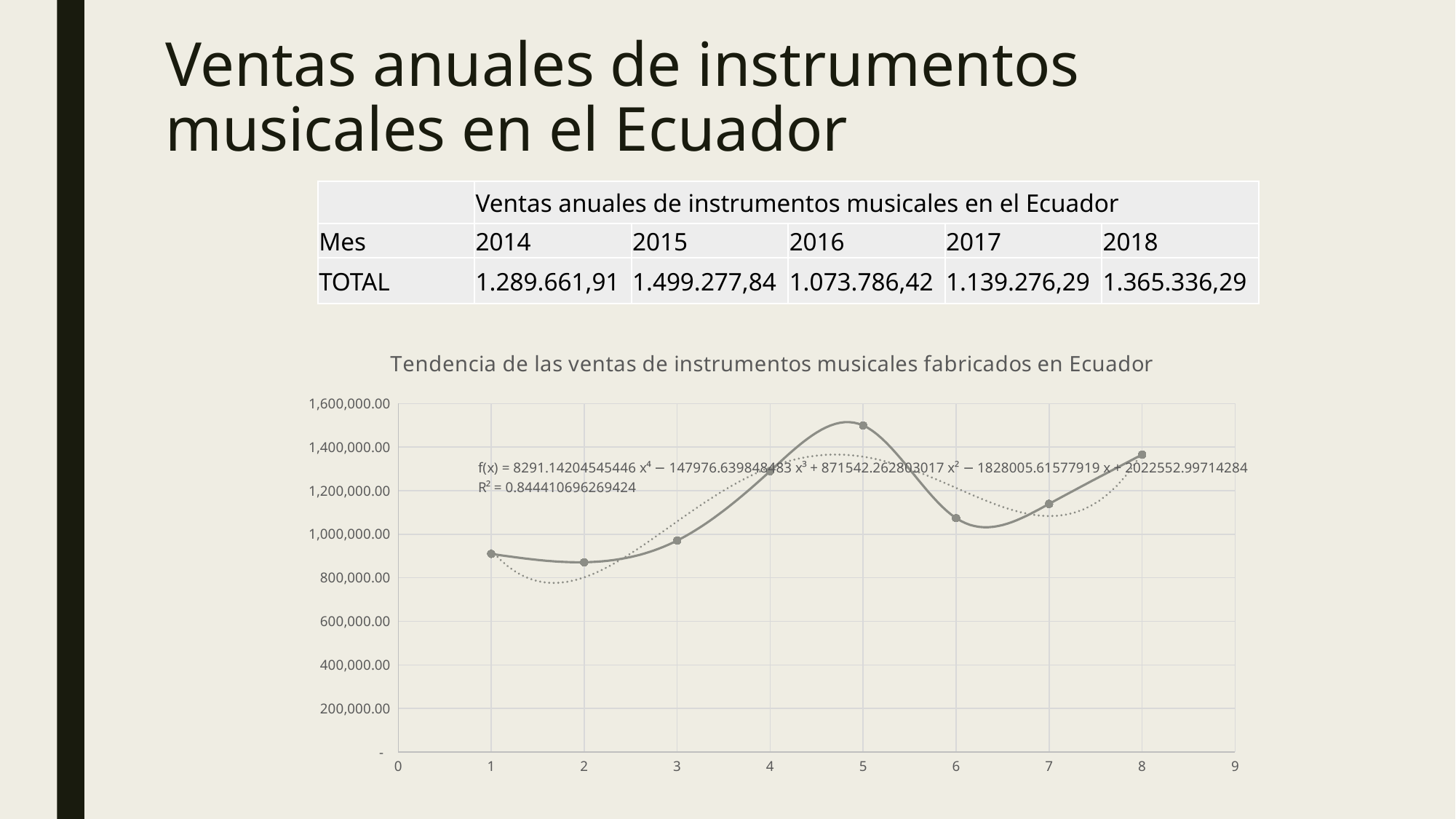
Which is larger, the value at x = 5 or the value at x = 8? x = 5 Is the value at x = 6 greater or less than 1,000,000.00? greater At which x value does the chart reach its highest point? 5 Is the value at x = 1 greater or less than 1,000,000.00? less How many data points are plotted on the chart? 8 What kind of chart is shown on the slide? line chart What R² value is printed on the chart for the trendline? 0.844410696269424 Is the value at x = 8 greater or less than 1,400,000.00? less What is the title of the chart? Tendencia de las ventas de instrumentos musicales fabricados en Ecuador At which x value does the chart reach its lowest point? 2 Do the values rise or fall from x = 2 to x = 5? rise